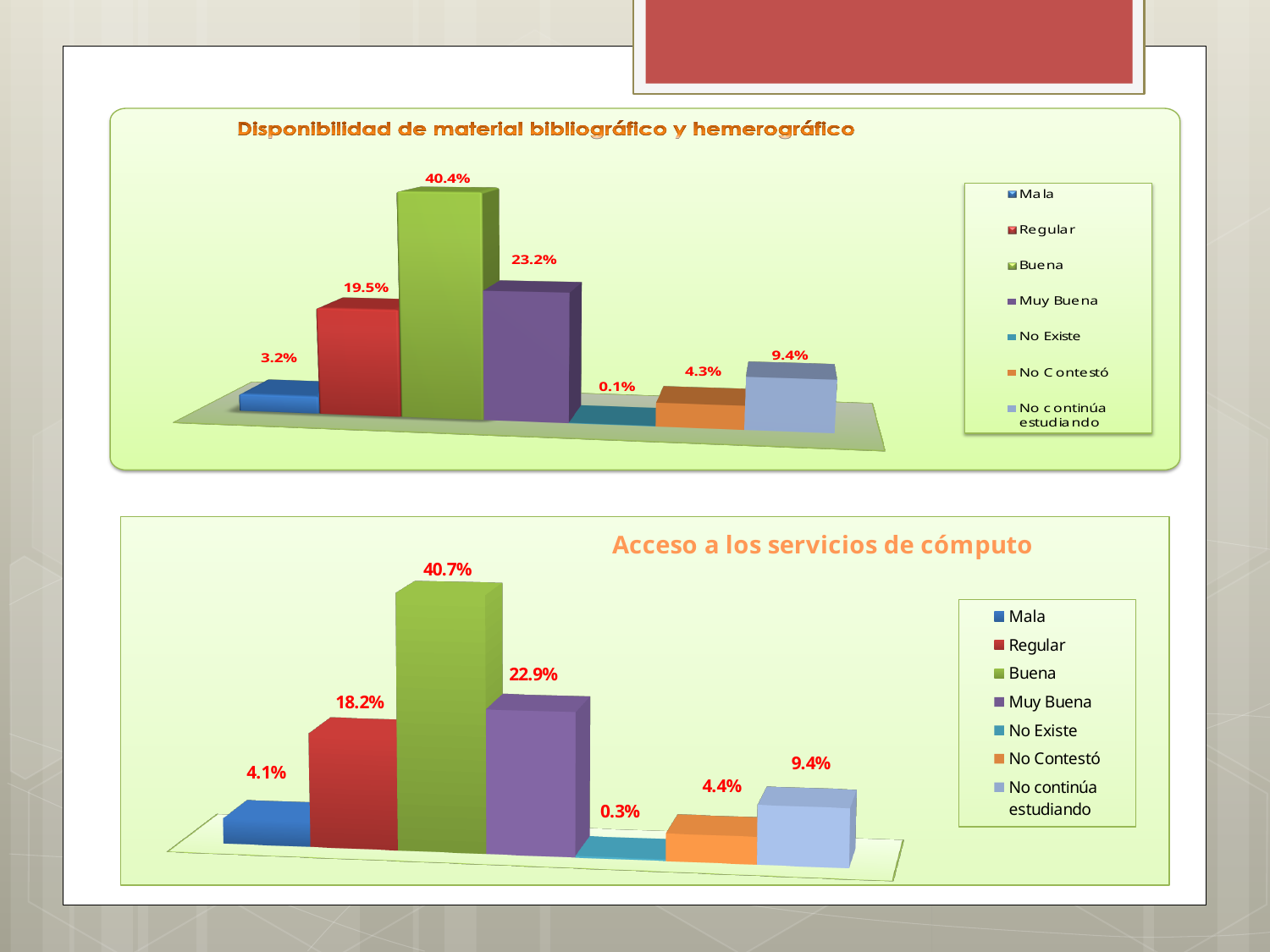
In the chart titled "Disponibilidad de material bibliográfico y hemerográfico", which category has the lowest value? No Existe In the chart titled "Disponibilidad de material bibliográfico y hemerográfico", what is the value for Regular? 19.5% In the chart titled "Acceso a los servicios de cómputo", which category has the highest value? Buena In the chart titled "Acceso a los servicios de cómputo", what is the value for No Existe? 0.3% In the chart titled "Disponibilidad de material bibliográfico y hemerográfico", what is the difference between Buena and Muy Buena? 17.2% In the chart titled "Disponibilidad de material bibliográfico y hemerográfico", what is the value for Buena? 40.4% In the chart titled "Acceso a los servicios de cómputo", what is the difference between Regular and Mala? 14.1% In the chart titled "Acceso a los servicios de cómputo", which is larger, Regular or No continúa estudiando? Regular In the chart titled "Disponibilidad de material bibliográfico y hemerográfico", how many series does the legend list? 7 In the chart titled "Acceso a los servicios de cómputo", what is the value for Muy Buena? 22.9% In the chart titled "Acceso a los servicios de cómputo", what colour is the bar for Buena? Green What kind of chart is the bottom chart on the slide? Bar chart